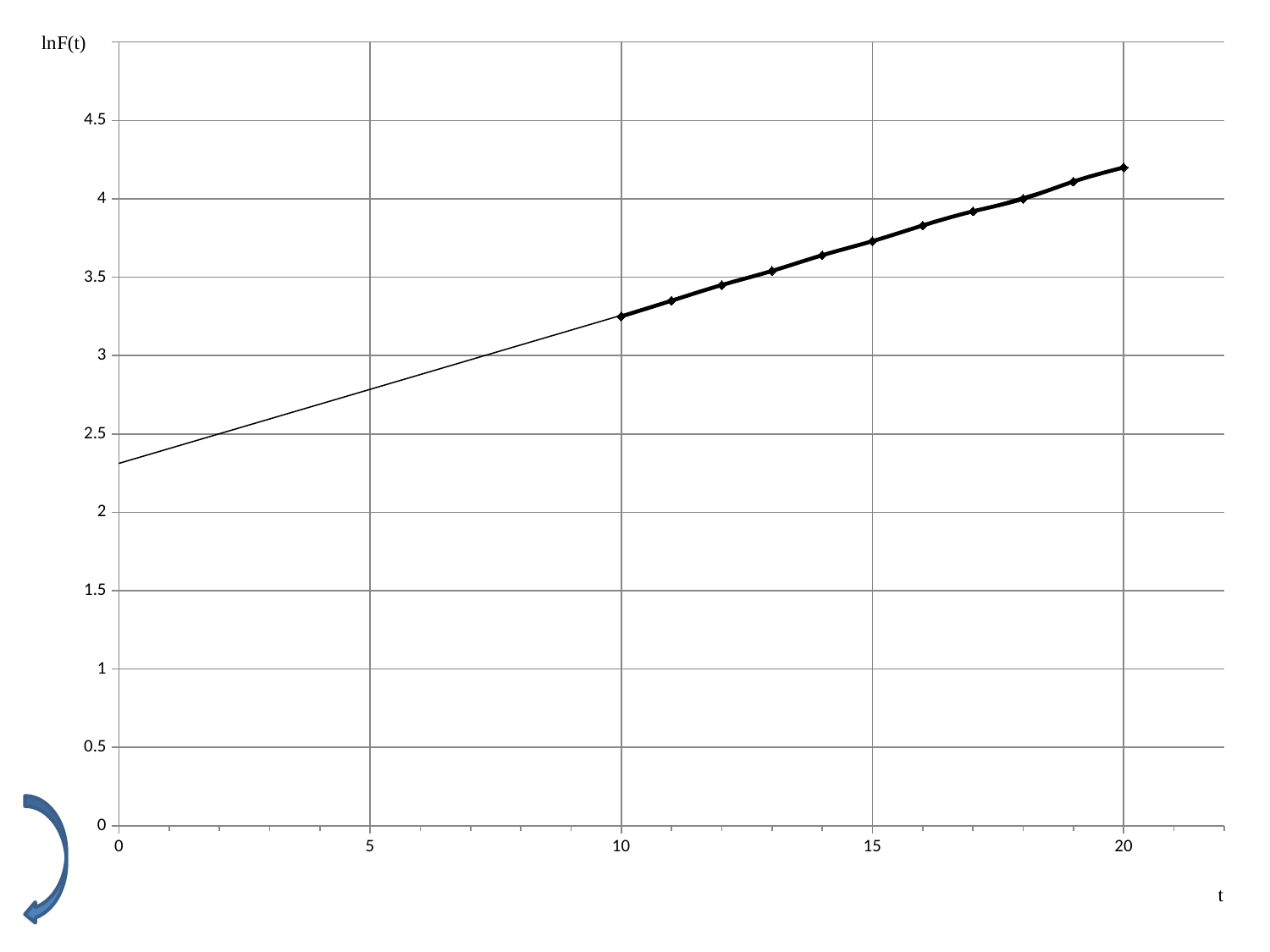
Is the value of lnF(t) at t = 16 greater or less than 3.5? greater How many marked data points are plotted on the thick line? 11 What label is shown on the vertical axis? lnF(t) What kind of chart is shown on the slide? line chart Is the value of lnF(t) at t = 20 greater or less than 4? greater At which value of t is the plotted lnF(t) highest? 20 Which is larger, lnF(t) at t = 13 or at t = 19? t = 19 Is the value of lnF(t) at t = 15 greater or less than 4? less At which value of t is the plotted lnF(t) lowest among the marked points? 10 Does lnF(t) rise or fall as t increases along the x axis? rise